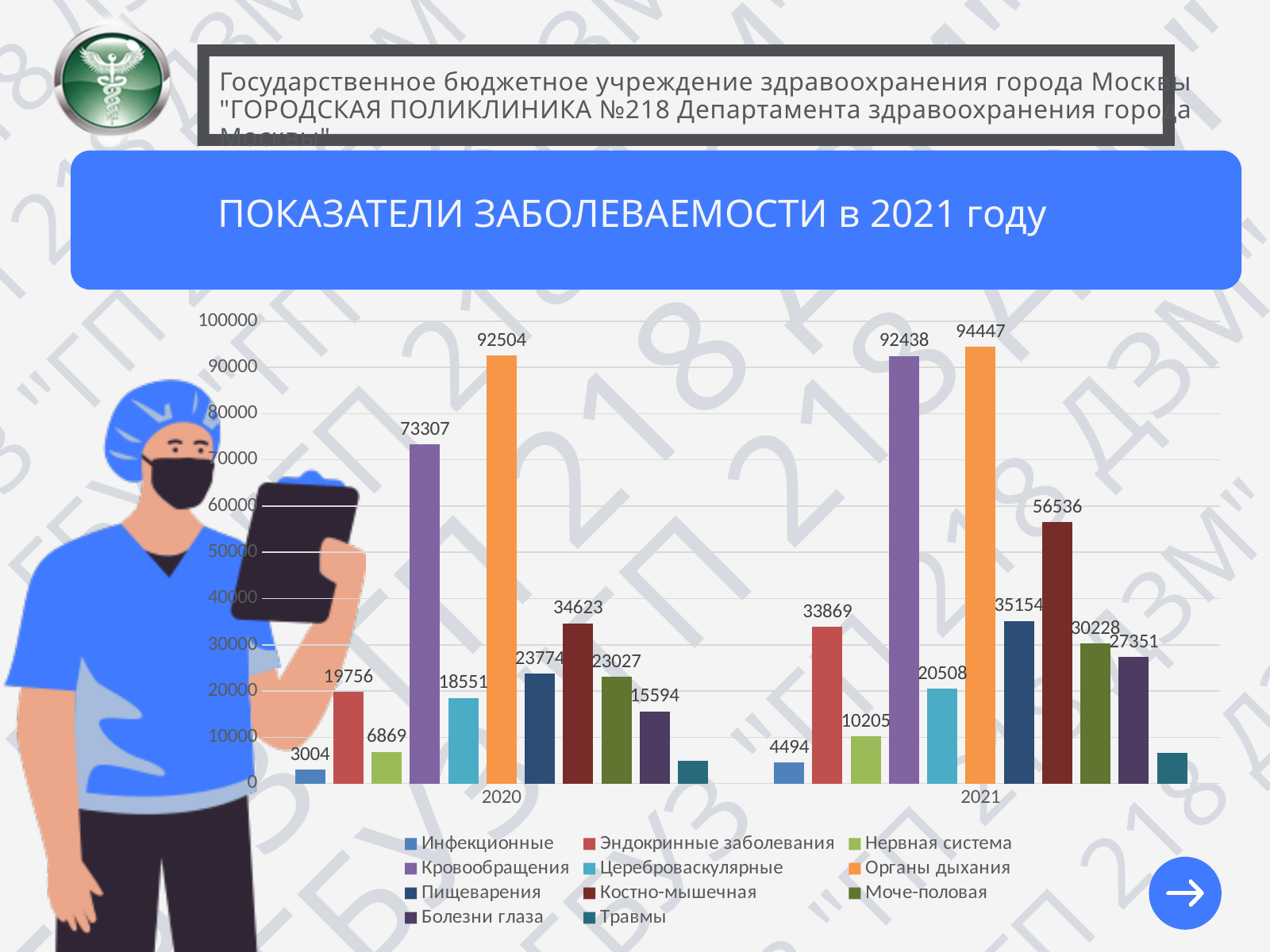
Is the value for Травмы in 2020 greater or less than 10000? less What kind of chart is shown on the slide? bar chart Which series has the highest value in 2020? Органы дыхания What is the difference between the Эндокринные заболевания values for 2021 and 2020? 14113 How many series does the legend list? 11 What is the value for Кровообращения in 2020? 73307 Does the value for Болезни глаза rise or fall from 2020 to 2021? rise How many year categories are shown on the x axis? 2 What is the value for Органы дыхания in 2021? 94447 What is the value for Костно-мышечная in 2021? 56536 Which series has the lowest value in 2020? Инфекционные Which is larger: Пищеварения in 2021 or Костно-мышечная in 2020? Пищеварения in 2021